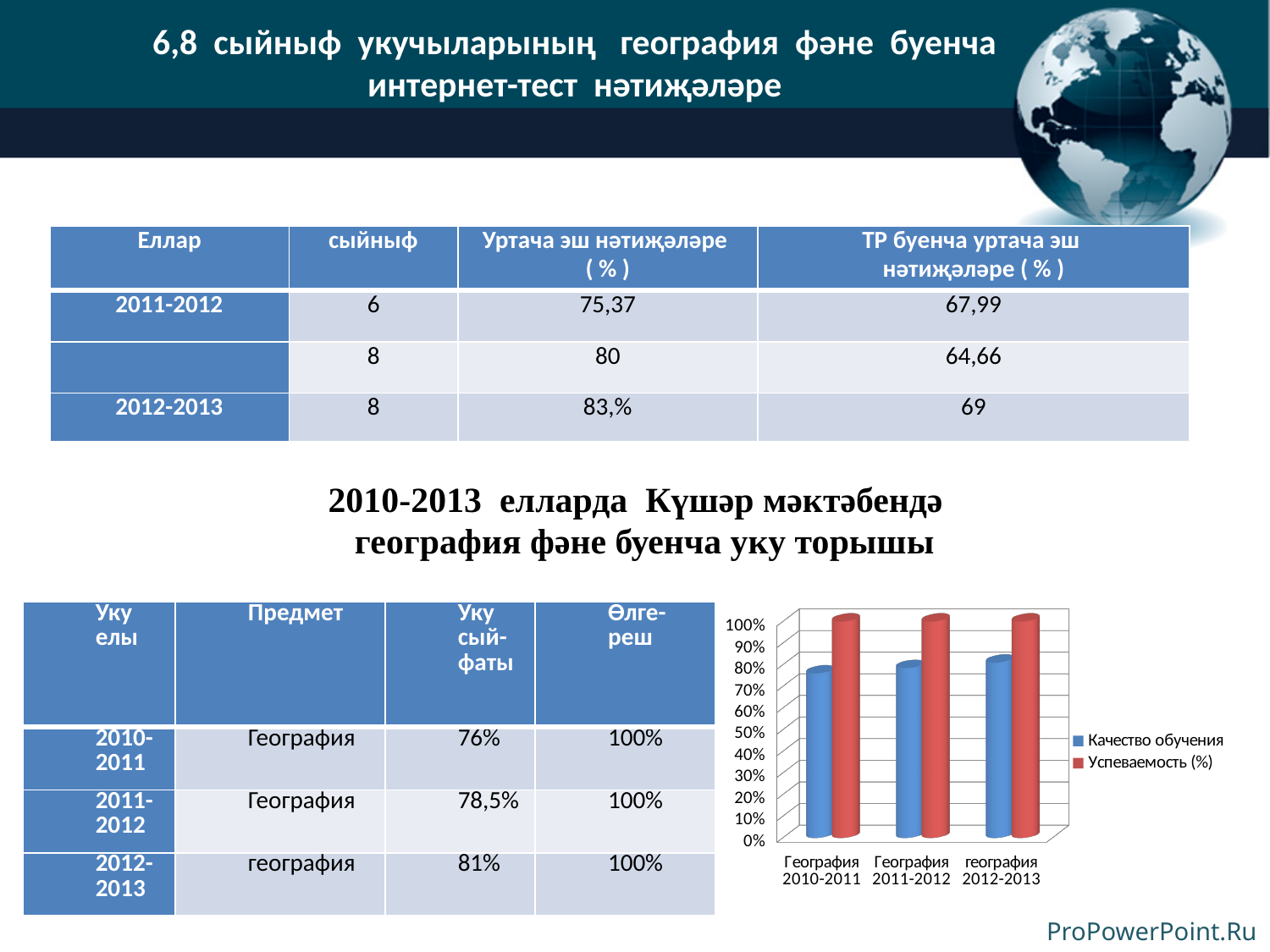
Does the Качество обучения series rise or fall from 2010-2011 to 2012-2013? rise Which colour represents the Успеваемость (%) series in the chart? red What are the two series named in the chart legend? Качество обучения and Успеваемость (%) For География 2011-2012, which series has the larger value, Качество обучения or Успеваемость (%)? Успеваемость (%) Is the value of Качество обучения for география 2012-2013 greater or less than 90%? less What is the value of Успеваемость (%) for география 2012-2013 in the chart? 100% Is the value of Качество обучения for География 2010-2011 greater or less than 70%? greater How many categories are plotted along the x axis of the chart? 3 Is the value of Качество обучения for География 2010-2011 greater or less than 80%? less How many series does the chart legend list? 2 What kind of chart is shown on the slide? bar chart What is the value of Успеваемость (%) for География 2010-2011 in the chart? 100%